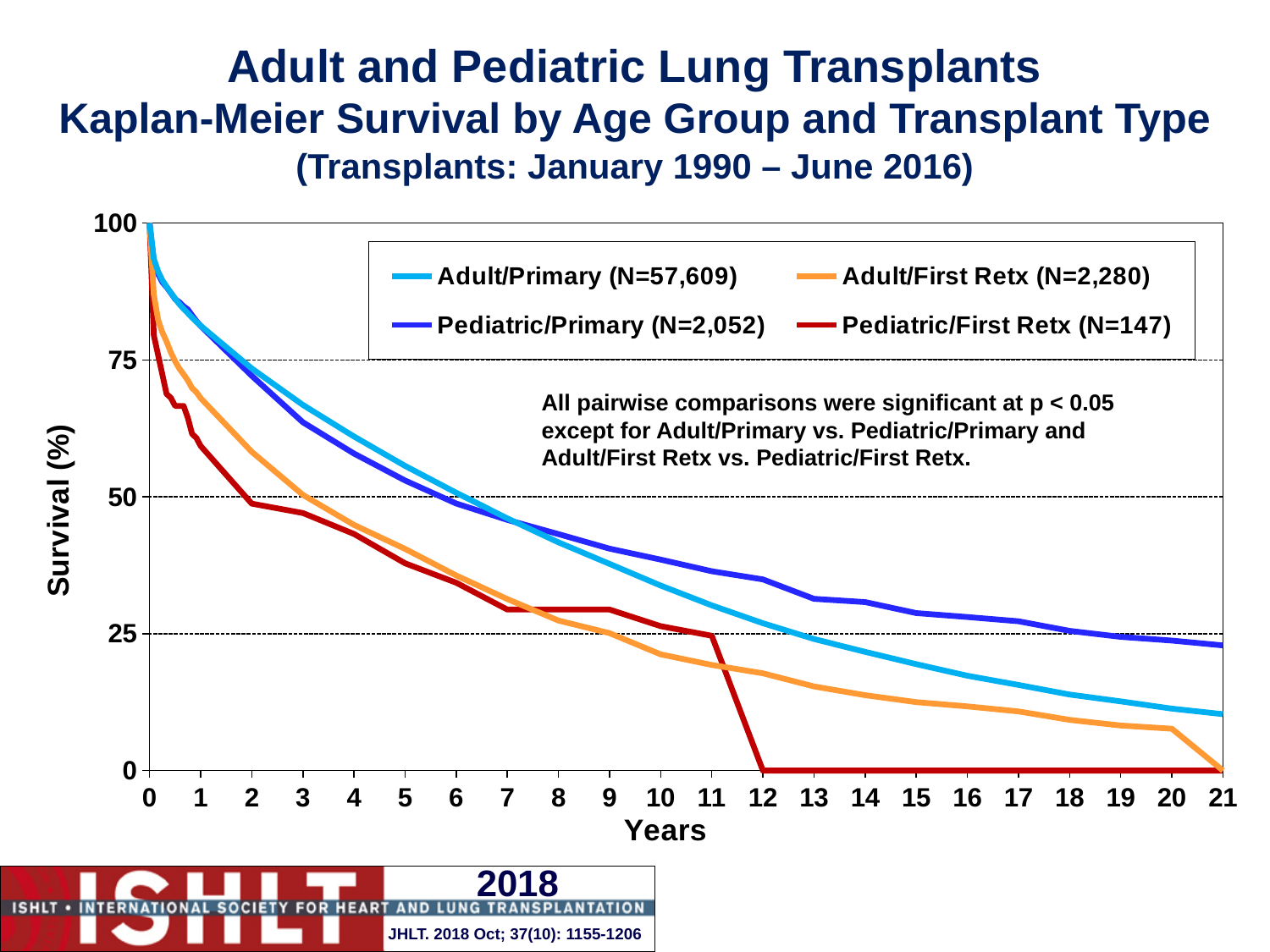
Is the survival for Adult/Primary at year 5 greater or less than 50? greater How many series does the legend list? 4 Is the survival for Adult/Primary at year 21 greater or less than 25? less Which series has the highest survival at year 20? Pediatric/Primary Which series is drawn in red? Pediatric/First Retx (N=147) What is the survival (%) for the Pediatric/First Retx series at year 12? 0 Do the survival curves rise or fall as years increase? Fall At year 15, which series has higher survival: Pediatric/Primary or Adult/Primary? Pediatric/Primary What is the N shown in the legend for the Adult/Primary series? 57,609 What kind of chart is shown on the slide? Line chart What is the survival (%) for the Adult/First Retx series at year 21? 0 Is the survival for Pediatric/Primary at year 10 greater or less than 50? less